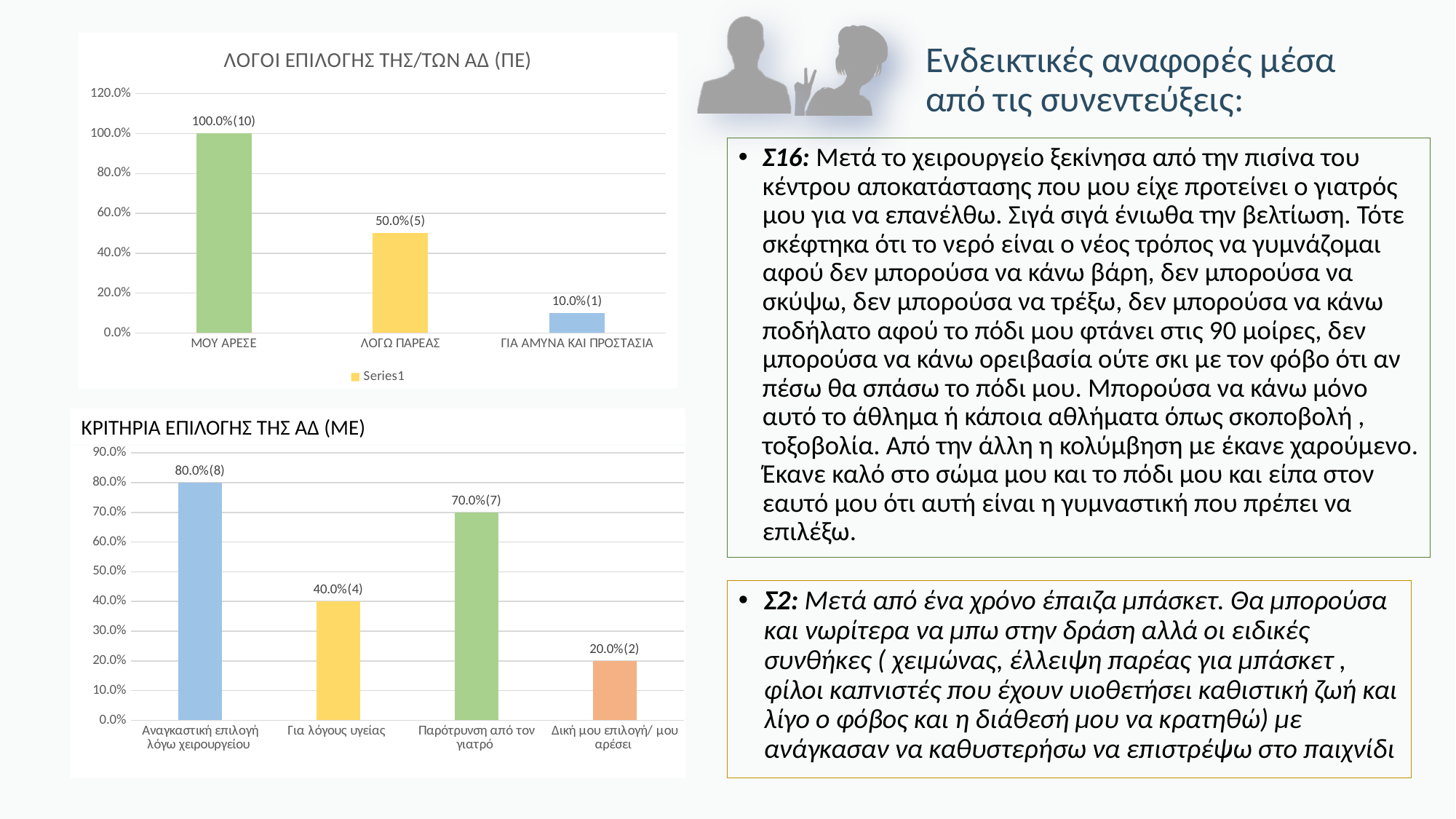
In the bottom chart 'ΚΡΙΤΗΡΙΑ ΕΠΙΛΟΓΗΣ ΤΗΣ ΑΔ (ΜΕ)', which category has the highest value? Αναγκαστική επιλογή λόγω χειρουργείου What type of chart is the bottom chart 'ΚΡΙΤΗΡΙΑ ΕΠΙΛΟΓΗΣ ΤΗΣ ΑΔ (ΜΕ)'? Bar chart In the bottom chart 'ΚΡΙΤΗΡΙΑ ΕΠΙΛΟΓΗΣ ΤΗΣ ΑΔ (ΜΕ)', what is the value for Παρότρυνση από τον γιατρό? 70.0%(7) In the top chart 'ΛΟΓΟΙ ΕΠΙΛΟΓΗΣ ΤΗΣ/ΤΩΝ ΑΔ (ΠΕ)', what is the legend entry? Series1 In the top chart 'ΛΟΓΟΙ ΕΠΙΛΟΓΗΣ ΤΗΣ/ΤΩΝ ΑΔ (ΠΕ)', which category has the lowest value? ΓΙΑ ΑΜΥΝΑ ΚΑΙ ΠΡΟΣΤΑΣΙΑ In the top chart 'ΛΟΓΟΙ ΕΠΙΛΟΓΗΣ ΤΗΣ/ΤΩΝ ΑΔ (ΠΕ)', what is the value for ΛΟΓΩ ΠΑΡΕΑΣ? 50.0%(5) In the bottom chart 'ΚΡΙΤΗΡΙΑ ΕΠΙΛΟΓΗΣ ΤΗΣ ΑΔ (ΜΕ)', what is the value for Δική μου επιλογή/ μου αρέσει? 20.0%(2) In the top chart 'ΛΟΓΟΙ ΕΠΙΛΟΓΗΣ ΤΗΣ/ΤΩΝ ΑΔ (ΠΕ)', what is the difference in percentage between ΜΟΥ ΑΡΕΣΕ and ΛΟΓΩ ΠΑΡΕΑΣ? 50.0% In the bottom chart 'ΚΡΙΤΗΡΙΑ ΕΠΙΛΟΓΗΣ ΤΗΣ ΑΔ (ΜΕ)', which is larger: Για λόγους υγείας or Παρότρυνση από τον γιατρό? Παρότρυνση από τον γιατρό In the bottom chart 'ΚΡΙΤΗΡΙΑ ΕΠΙΛΟΓΗΣ ΤΗΣ ΑΔ (ΜΕ)', how many categories are shown? 4 In the top chart 'ΛΟΓΟΙ ΕΠΙΛΟΓΗΣ ΤΗΣ/ΤΩΝ ΑΔ (ΠΕ)', which category has the highest value? ΜΟΥ ΑΡΕΣΕ In the top chart 'ΛΟΓΟΙ ΕΠΙΛΟΓΗΣ ΤΗΣ/ΤΩΝ ΑΔ (ΠΕ)', how many categories are shown? 3